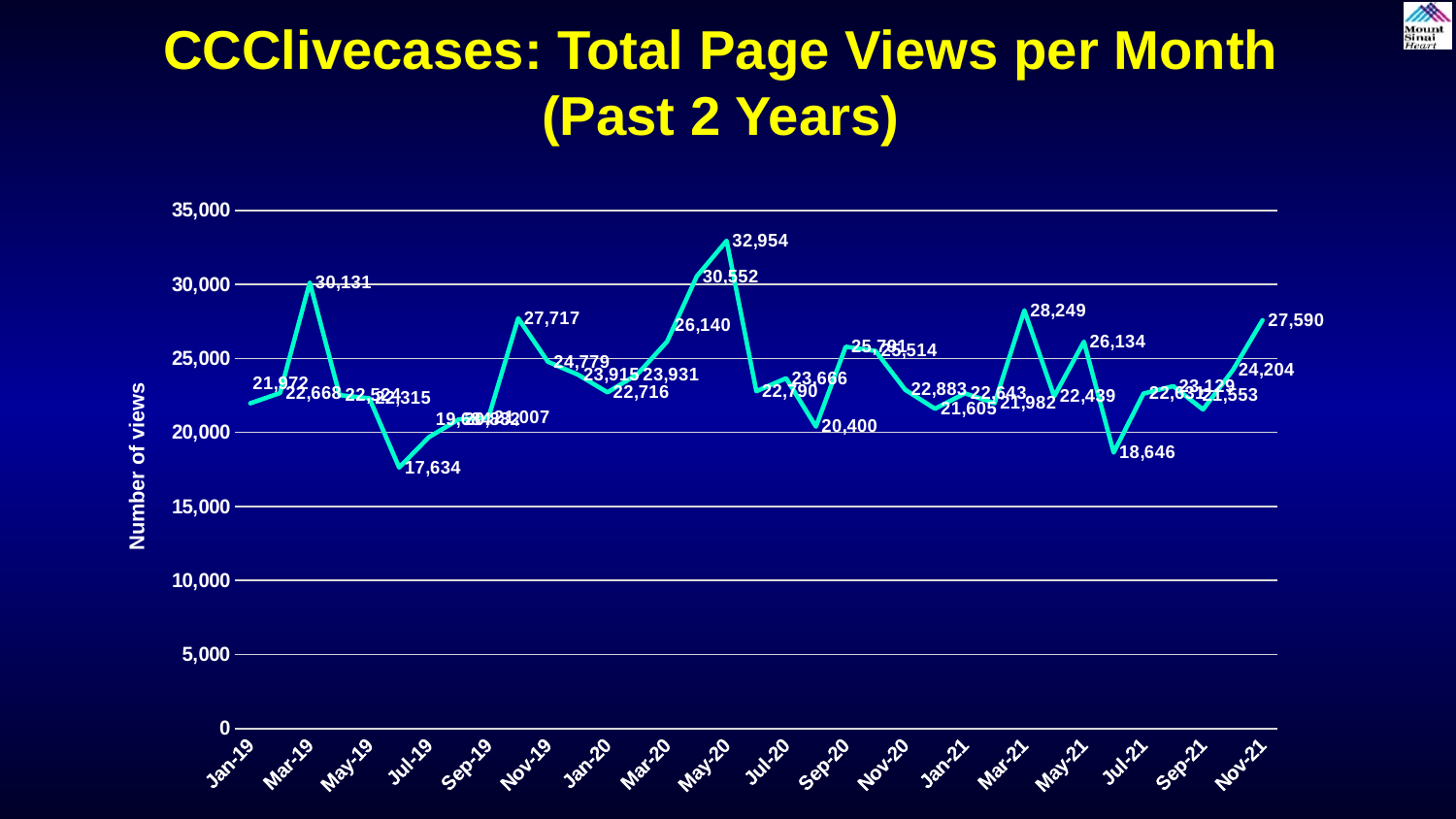
What is the highest number of page views shown on the chart? 32,954 Is the value for Nov-21 greater or less than 25,000? greater What type of chart is shown on the slide? line chart What is the number of page views for Nov-21? 27,590 What is the lowest number of page views shown on the chart? 17,634 What is the difference between the highest value (32,954) and the lowest value (17,634) on the chart? 15,320 Which is larger, the value for May-20 or the value for Jan-19? May-20 How many month labels are shown on the x axis? 18 What is the title of the y axis? Number of views What is the number of page views for Jan-19? 21,972 In which month did page views reach their highest value? May-20 How much higher is the value for Nov-21 (27,590) than the value for Jan-19 (21,972)? 5,618